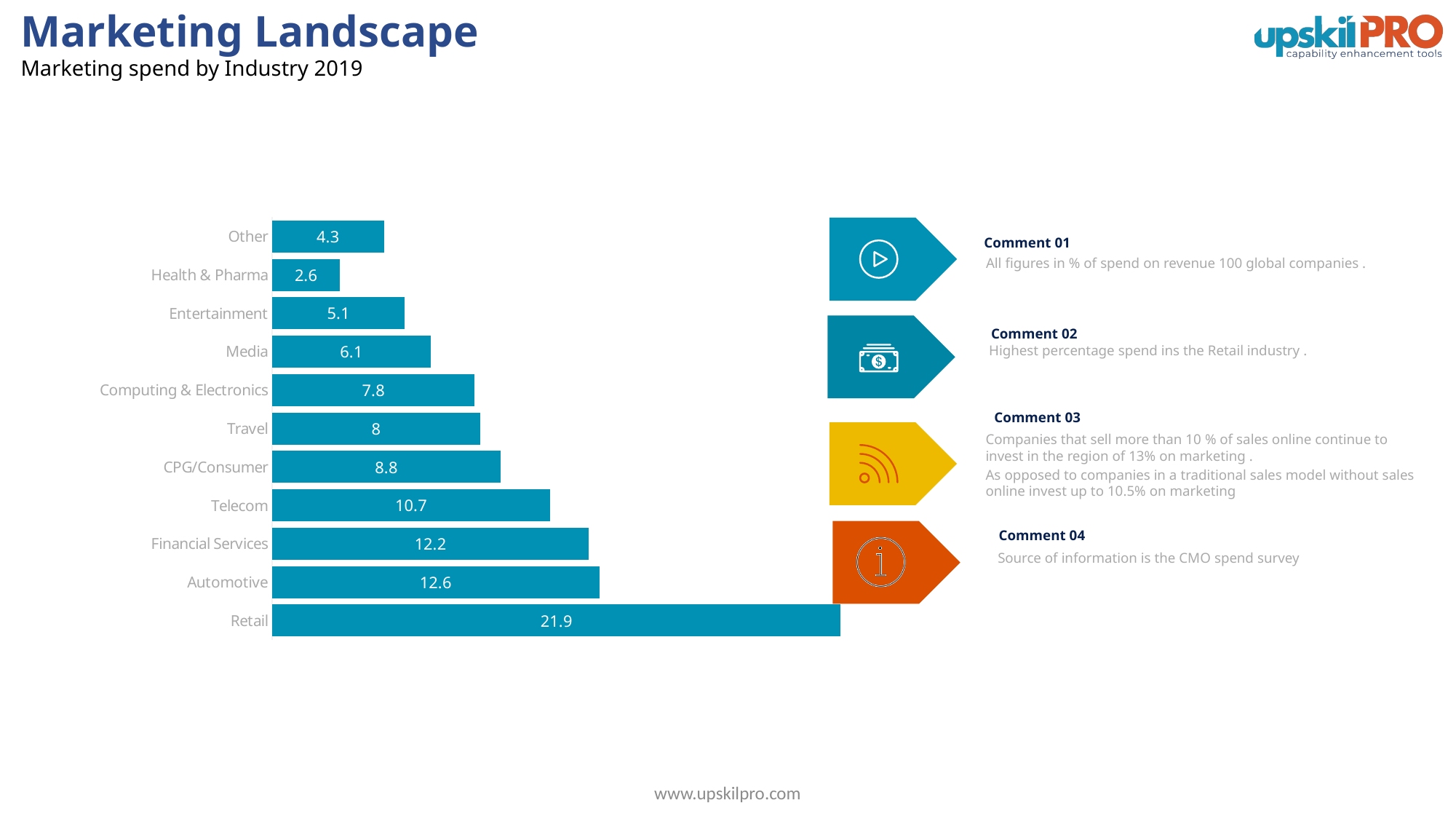
Which industry has the highest value? Retail What is the value for Telecom? 10.7 What is the subtitle of the chart on the slide? Marketing spend by Industry 2019 How many industries are shown in the chart? 11 What is the value for Retail? 21.9 Which industry has the lowest value? Health & Pharma Which is larger, the value for Financial Services or the value for Telecom? Financial Services What is the difference between the values for Media and Entertainment? 1 What is the value for Computing & Electronics? 7.8 What is the value for Health & Pharma? 2.6 What kind of chart is shown on the slide? Bar chart What is the difference between the values for Retail and Automotive? 9.3